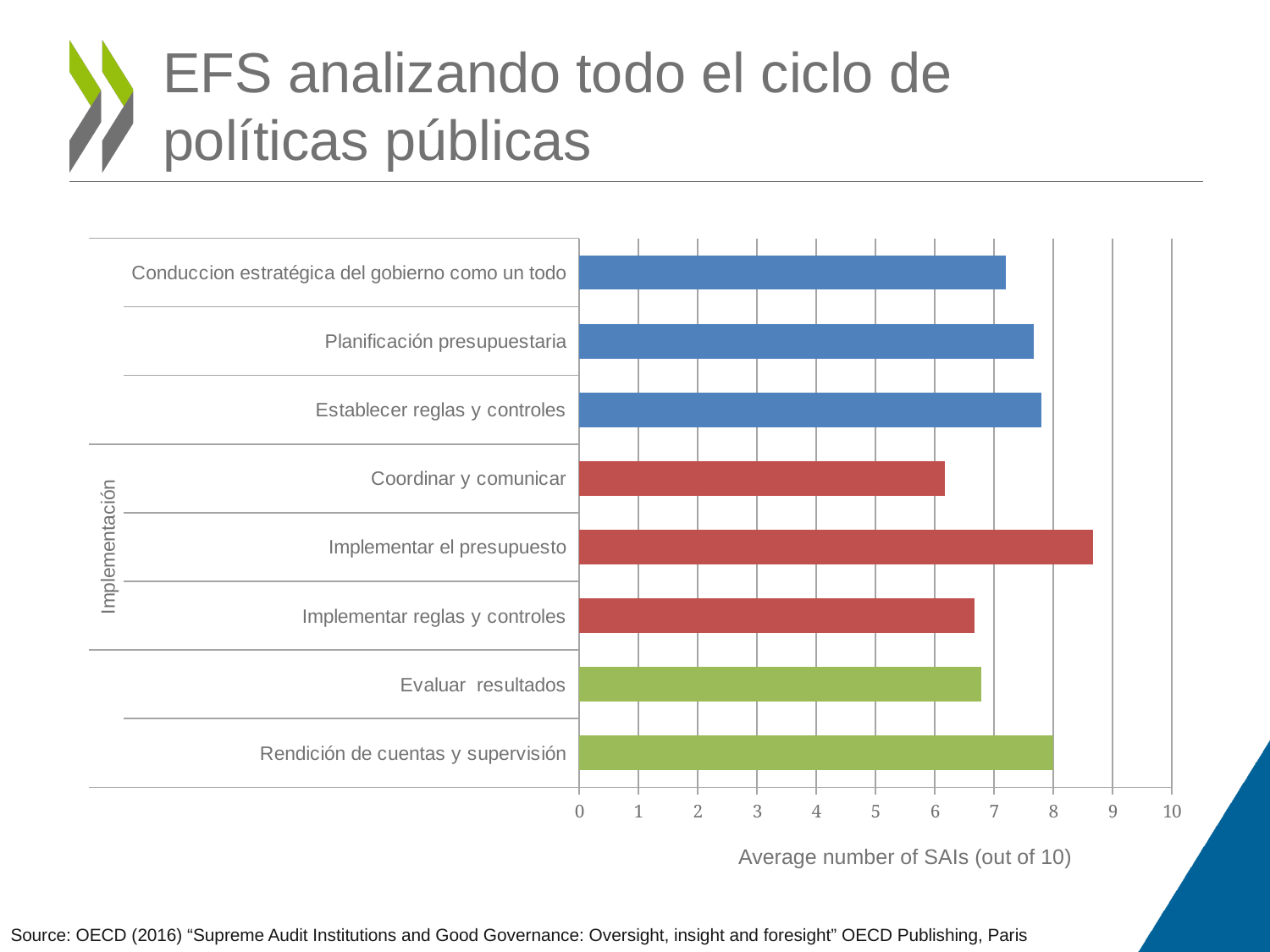
Which is larger, the value for Implementar el presupuesto or the value for Coordinar y comunicar? Implementar el presupuesto How many categories (bars) does the chart show? 8 Is the value for Implementar el presupuesto greater or less than 8? greater What is the title of the horizontal axis of the chart? Average number of SAIs (out of 10) Is the value for Coordinar y comunicar greater or less than 7? less Which category has the lowest average number of SAIs? Coordinar y comunicar Is the value for Establecer reglas y controles greater or less than 8? less Which category has the highest average number of SAIs? Implementar el presupuesto What kind of chart is shown on the slide? bar chart Which is larger, the value for Rendición de cuentas y supervisión or the value for Evaluar resultados? Rendición de cuentas y supervisión